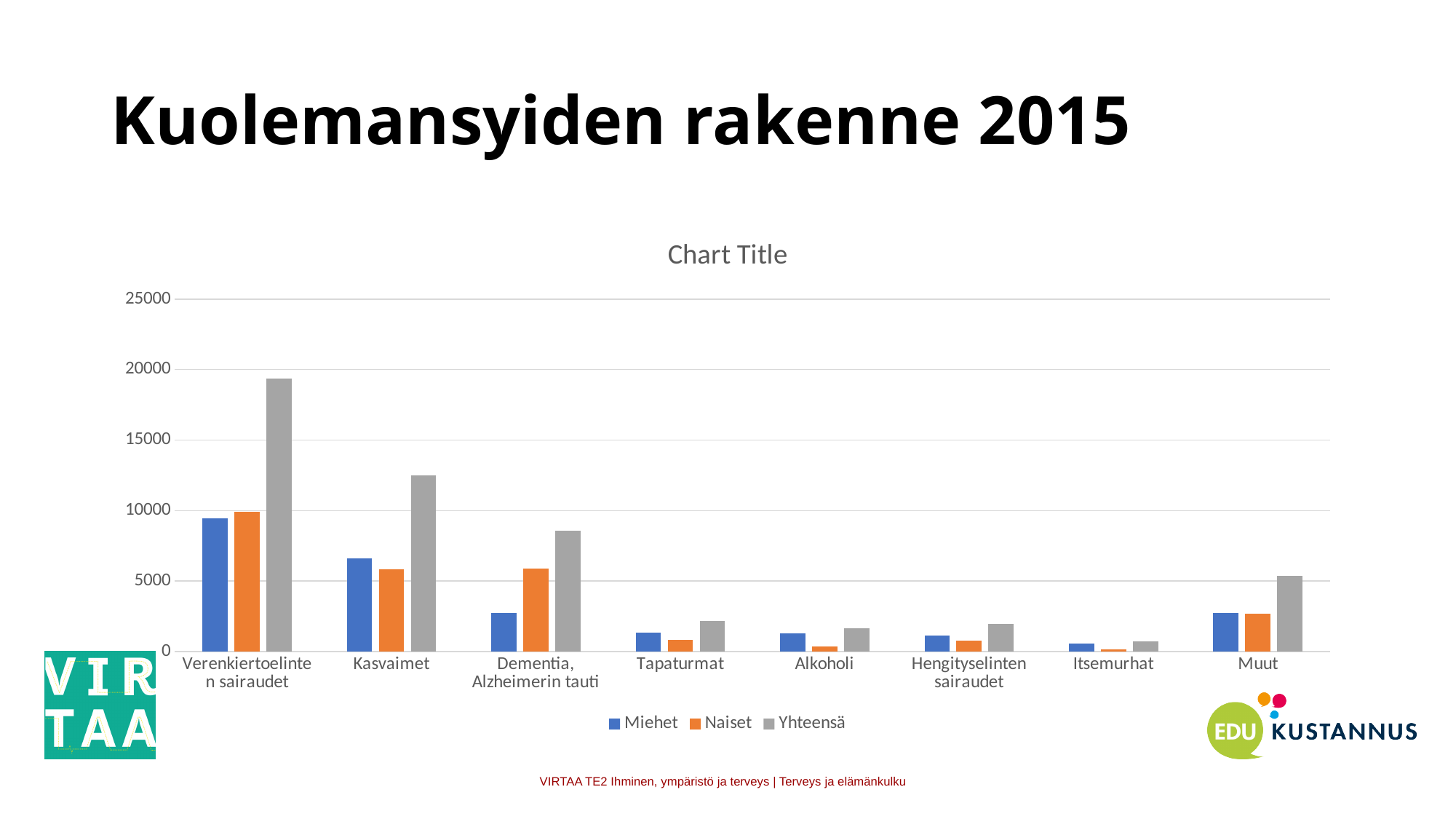
For Kasvaimet, which is larger: Miehet or Naiset? Miehet For Dementia, Alzheimerin tauti, which is larger: Miehet or Naiset? Naiset Which category has the lowest Yhteensä value? Itsemurhat What is the title shown above the chart? Chart Title What kind of chart is shown on the slide? Bar chart Is the Yhteensä value for Verenkiertoelinten sairaudet greater or less than 15000? greater Which category has the highest Yhteensä value? Verenkiertoelinten sairaudet Is the Yhteensä value for Kasvaimet greater or less than 10000? greater What colour represents the Yhteensä series in the legend? Grey How many categories are shown on the x axis? 8 Is the Yhteensä value for Dementia, Alzheimerin tauti greater or less than 10000? less How many series does the legend list? 3